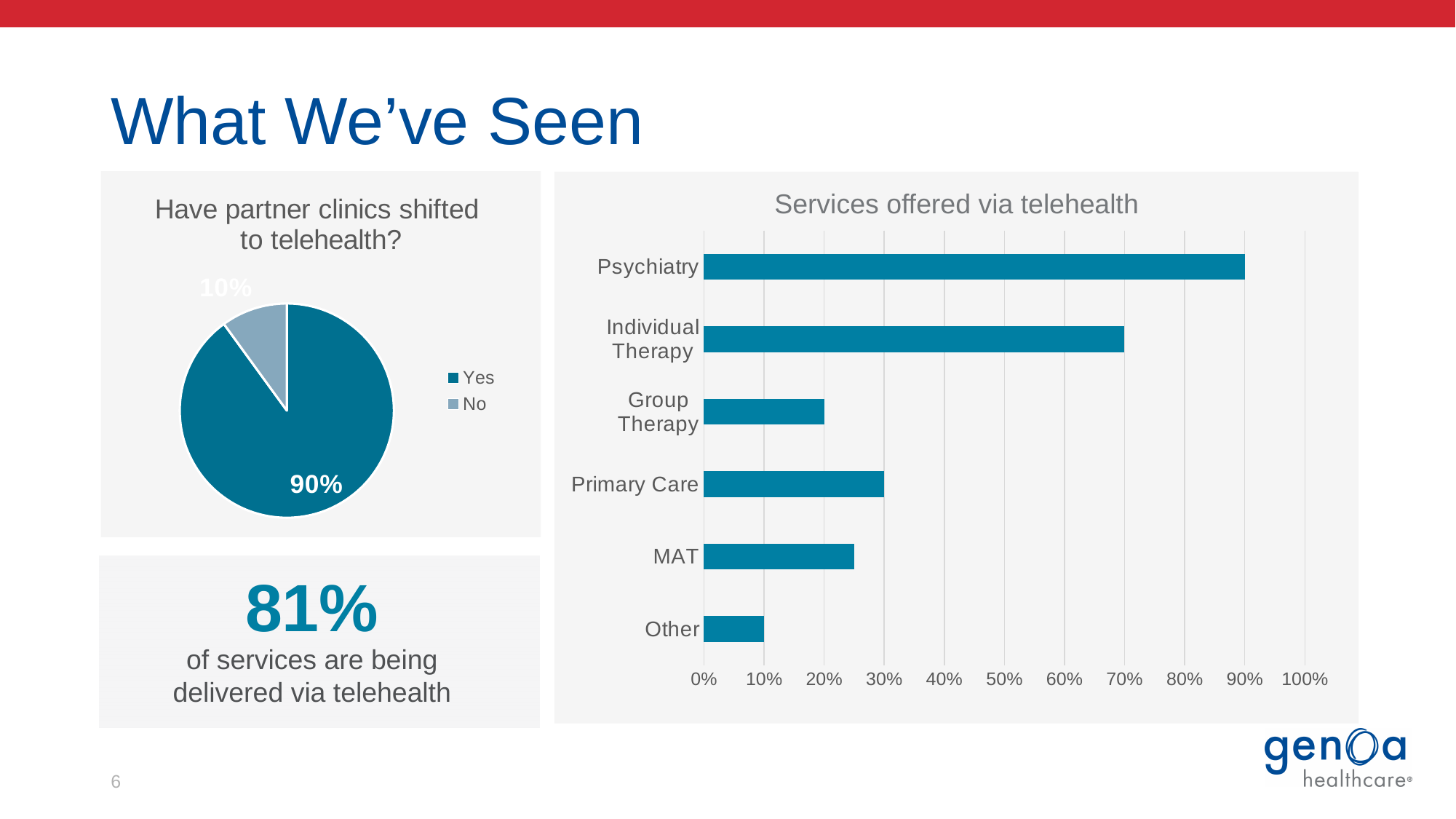
In the "Services offered via telehealth" chart, is the value for MAT greater or less than 30%? less In the "Services offered via telehealth" chart, what is the value for Psychiatry? 90% In the pie chart "Have partner clinics shifted to telehealth?", what share of the pie is "Yes"? 90% What kind of chart is the chart on the left of the slide? Pie chart In the "Services offered via telehealth" chart, is the value for Individual Therapy greater or less than 60%? greater In the pie chart "Have partner clinics shifted to telehealth?", what share of the pie is "No"? 10% In the pie chart "Have partner clinics shifted to telehealth?", how many entries does the legend list? 2 In the "Services offered via telehealth" chart, how many service categories are shown? 6 What kind of chart is "Services offered via telehealth"? Bar chart In the "Services offered via telehealth" chart, which is larger, Primary Care or Group Therapy? Primary Care In the "Services offered via telehealth" chart, which service has the lowest value? Other In the "Services offered via telehealth" chart, which service has the highest value? Psychiatry